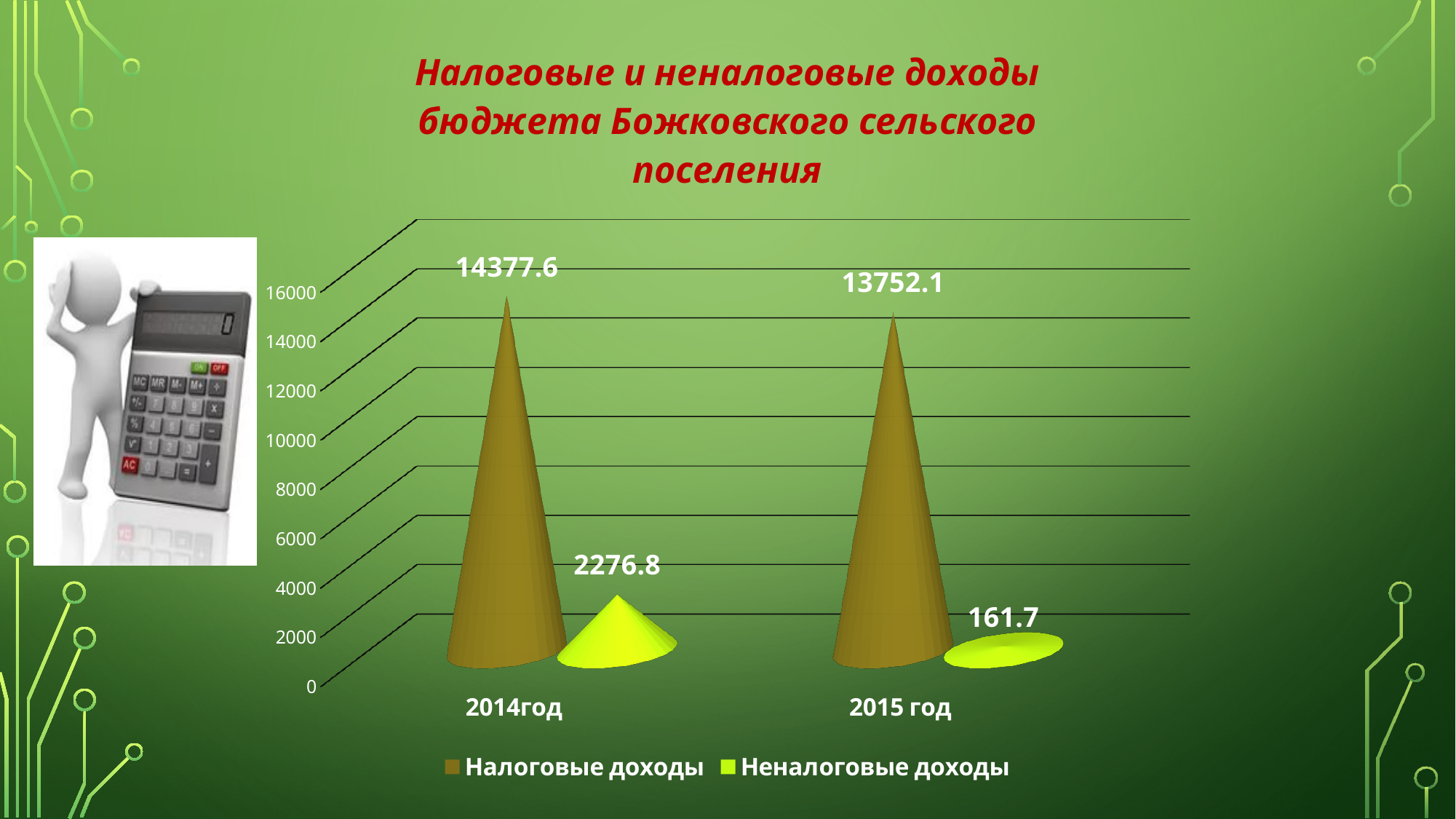
Is the value of Налоговые доходы for 2015 год greater or less than 12000? greater What is the value of Налоговые доходы for 2014год? 14377.6 Which year has the lowest value of Неналоговые доходы? 2015 год Which is larger in 2015 год: Налоговые доходы or Неналоговые доходы? Налоговые доходы Which year has the higher value of Налоговые доходы? 2014год What is the difference between Налоговые доходы in 2014год and 2015 год? 625.5 What is the value of Налоговые доходы for 2015 год? 13752.1 What is the value of Неналоговые доходы for 2015 год? 161.7 What is the difference between Неналоговые доходы in 2014год and 2015 год? 2115.1 What is the value of Неналоговые доходы for 2014год? 2276.8 Do the values of Неналоговые доходы rise or fall from 2014год to 2015 год? fall How many series does the legend list? 2